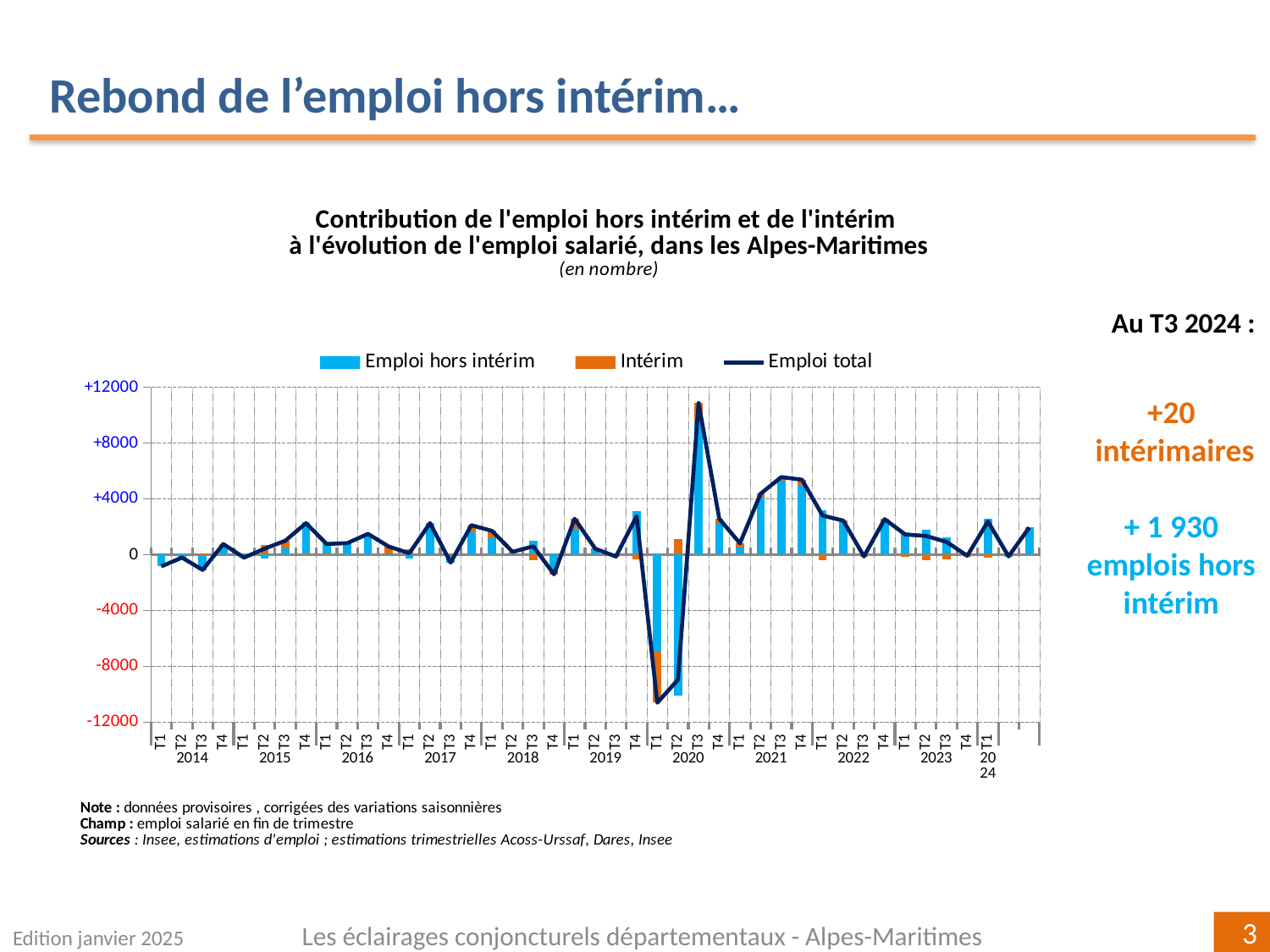
Is the Emploi total value for T1 2020 greater or less than -8000? less Which is larger, the Emploi total value for T3 2020 or for T3 2021? T3 2020 Is the Emploi total value for T3 2020 greater or less than 8000? greater Which series is shown in orange? Intérim Is the Emploi hors intérim value for T3 2021 greater or less than 4000? greater According to the slide, what is the change in intérimaires at T3 2024? +20 According to the slide, what is the change in emplois hors intérim at T3 2024? + 1 930 What kind of chart is shown on the slide? A combined bar and line chart How many series does the chart legend list? 3 In which quarter does the Emploi total line reach its highest value? T3 2020 In which quarter does the Emploi total line reach its lowest value? T1 2020 Which series is drawn as a line rather than bars? Emploi total